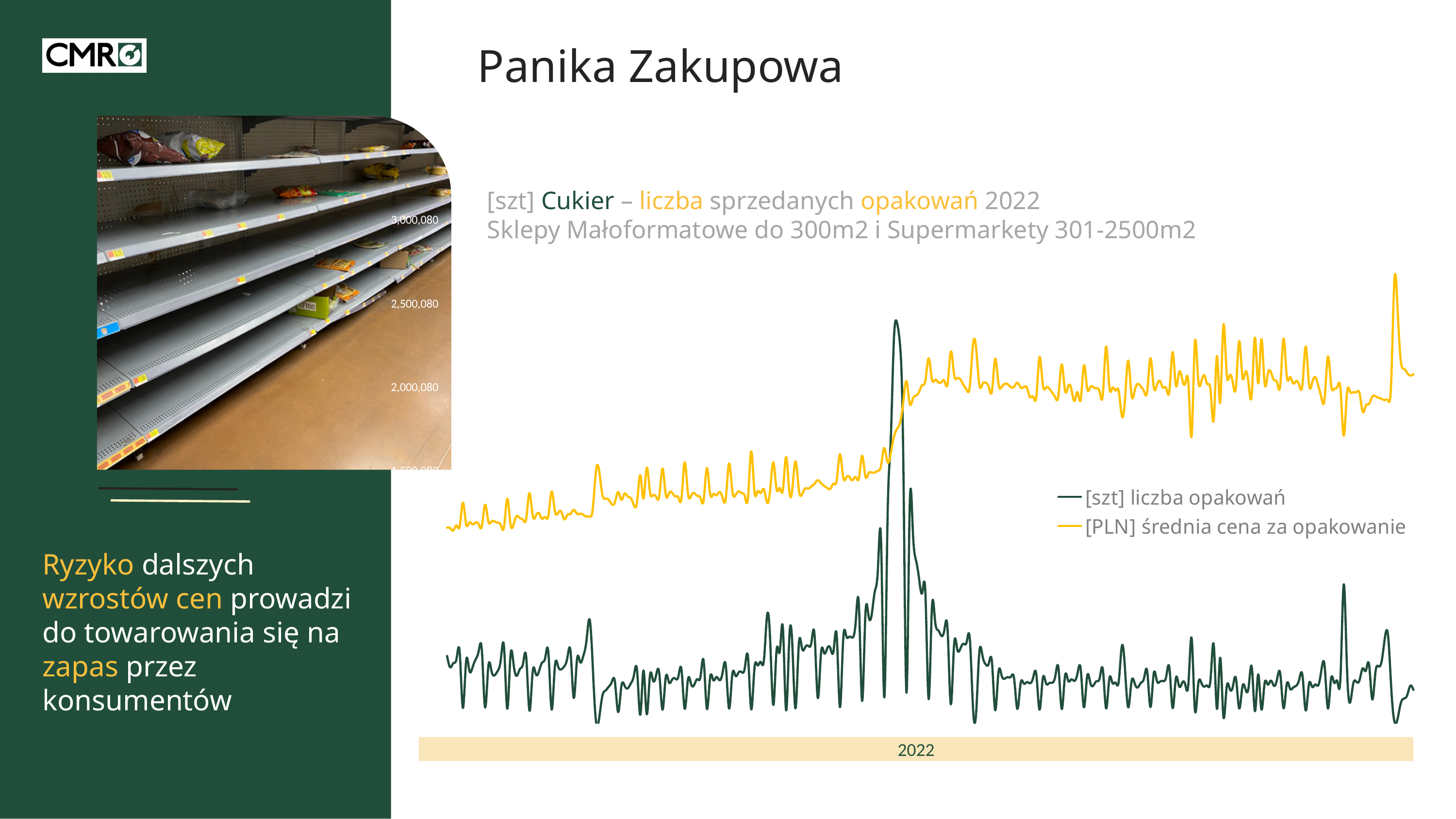
What is the legend label of the dark green line? [szt] liczba opakowań What is the legend label of the yellow line? [PLN] średnia cena za opakowanie Which year is shown on the x axis of the chart? 2022 What kind of chart is shown on the slide? line chart Does the [PLN] średnia cena za opakowanie line generally rise or fall across 2022? rise How many series does the chart legend list? 2